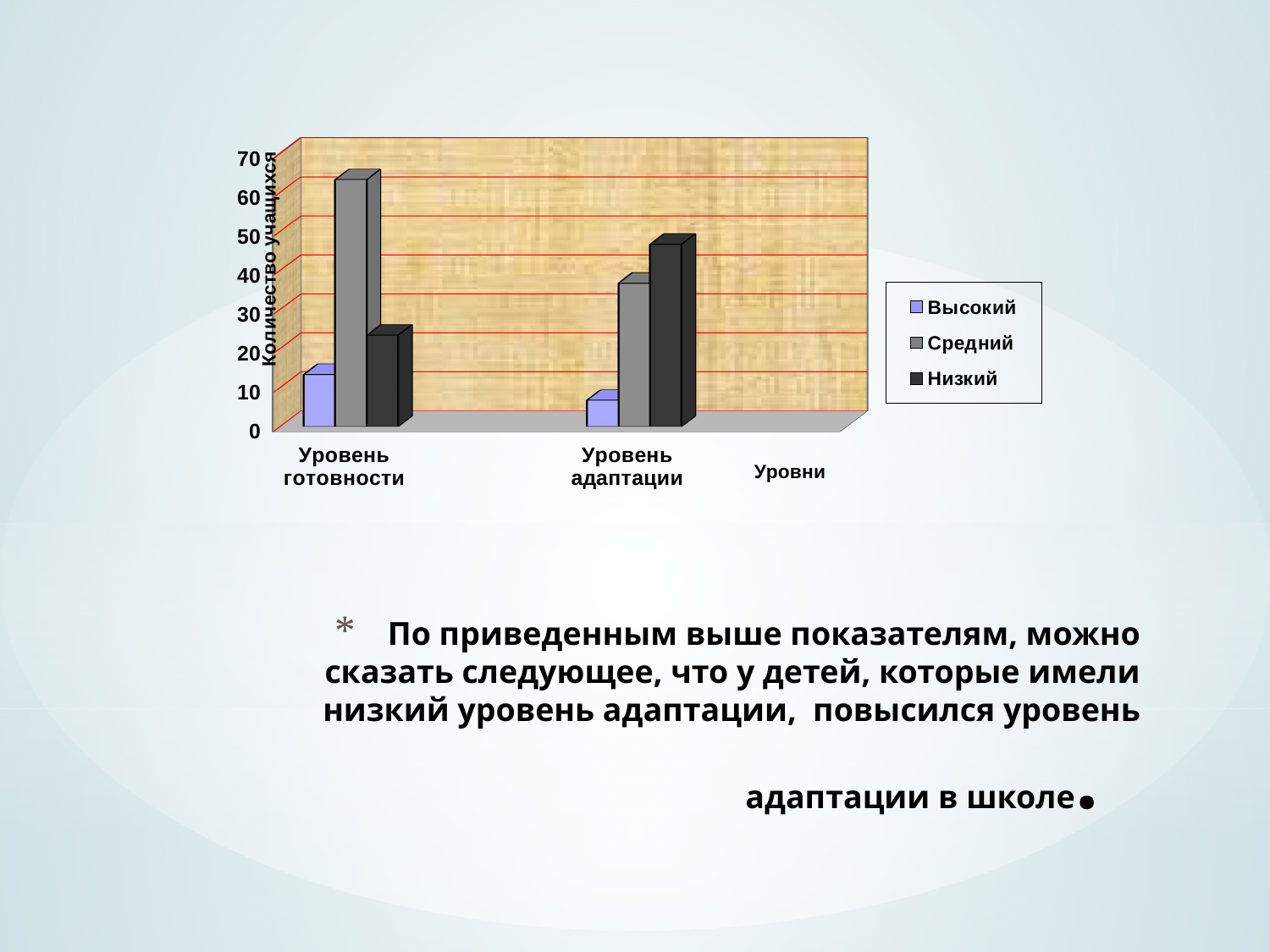
Which is larger: the "Средний" value for "Уровень готовности" or the "Средний" value for "Уровень адаптации"? Уровень готовности Which series has the lowest bar in the "Уровень адаптации" category? Высокий Is the value for "Низкий" in "Уровень адаптации" greater or less than 40? greater Which series has the highest bar in the "Уровень адаптации" category? Низкий Which series has the highest bar in the "Уровень готовности" category? Средний How many categories are shown on the x axis? 2 Is the value for "Средний" in "Уровень готовности" greater or less than 50? greater Which is larger: the "Низкий" value for "Уровень готовности" or the "Низкий" value for "Уровень адаптации"? Уровень адаптации What kind of chart is shown on the slide? bar chart Is the value for "Высокий" in "Уровень адаптации" greater or less than 10? less What is the title of the vertical axis? Количество учащихся How many series does the legend list? 3